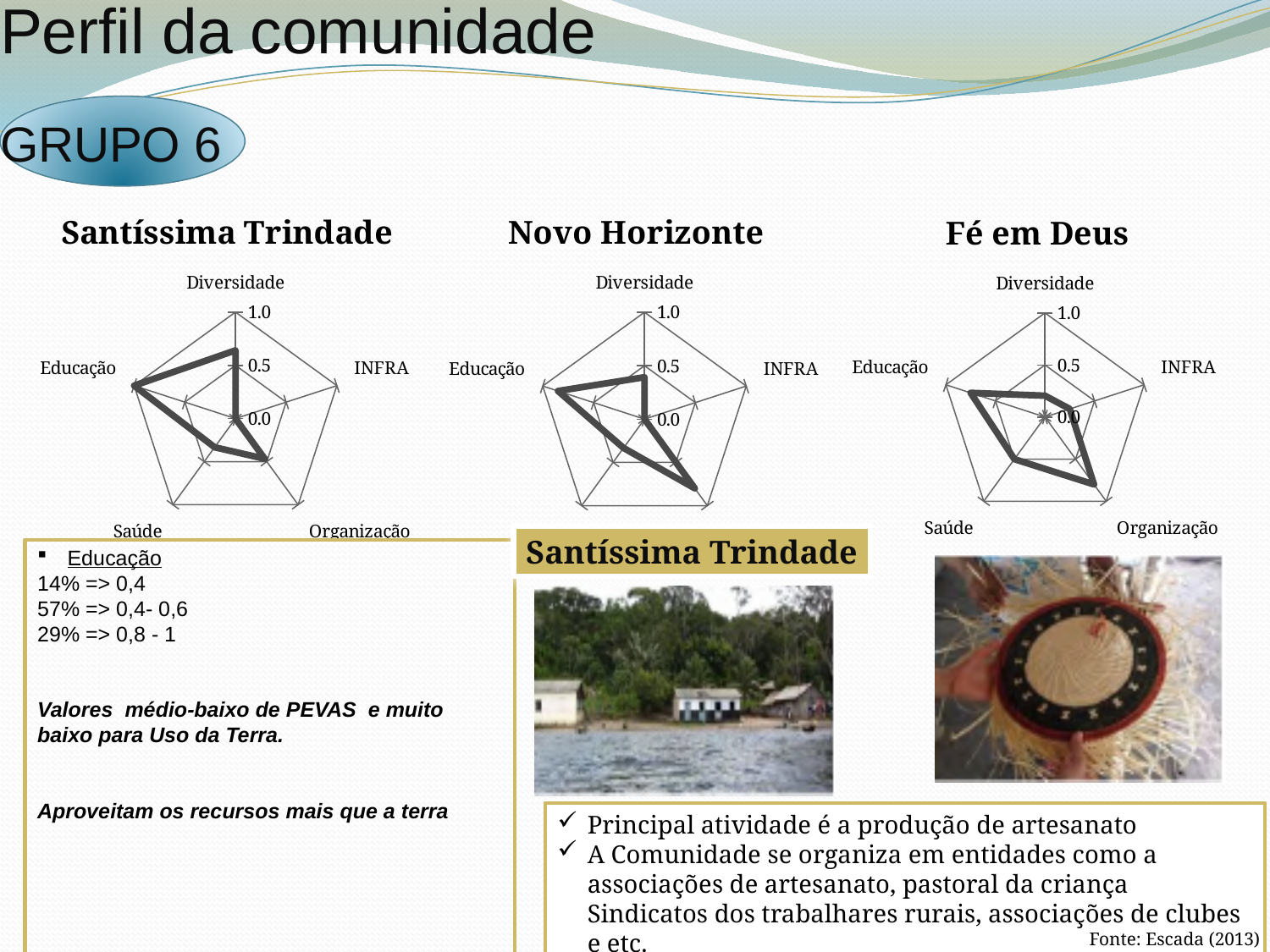
In the Fé em Deus chart, is the value for Diversidade greater or less than 0.5? less In the Novo Horizonte chart, is the value for INFRA greater or less than 0.5? less In the Santíssima Trindade chart, is the value for Educação greater or less than 0.5? greater What kind of chart is used for Santíssima Trindade? Radar chart How many axes (categories) does the Novo Horizonte radar chart have? 5 In the Santíssima Trindade chart, which category has the highest value? Educação In the Fé em Deus chart, which is larger, the value for Educação or the value for INFRA? Educação In the Fé em Deus chart, which category has the highest value? Organização How many radar charts are shown on the slide? 3 In the Santíssima Trindade chart, which category has the lowest value? INFRA What is the maximum value shown on the axis scale of the Novo Horizonte chart? 1.0